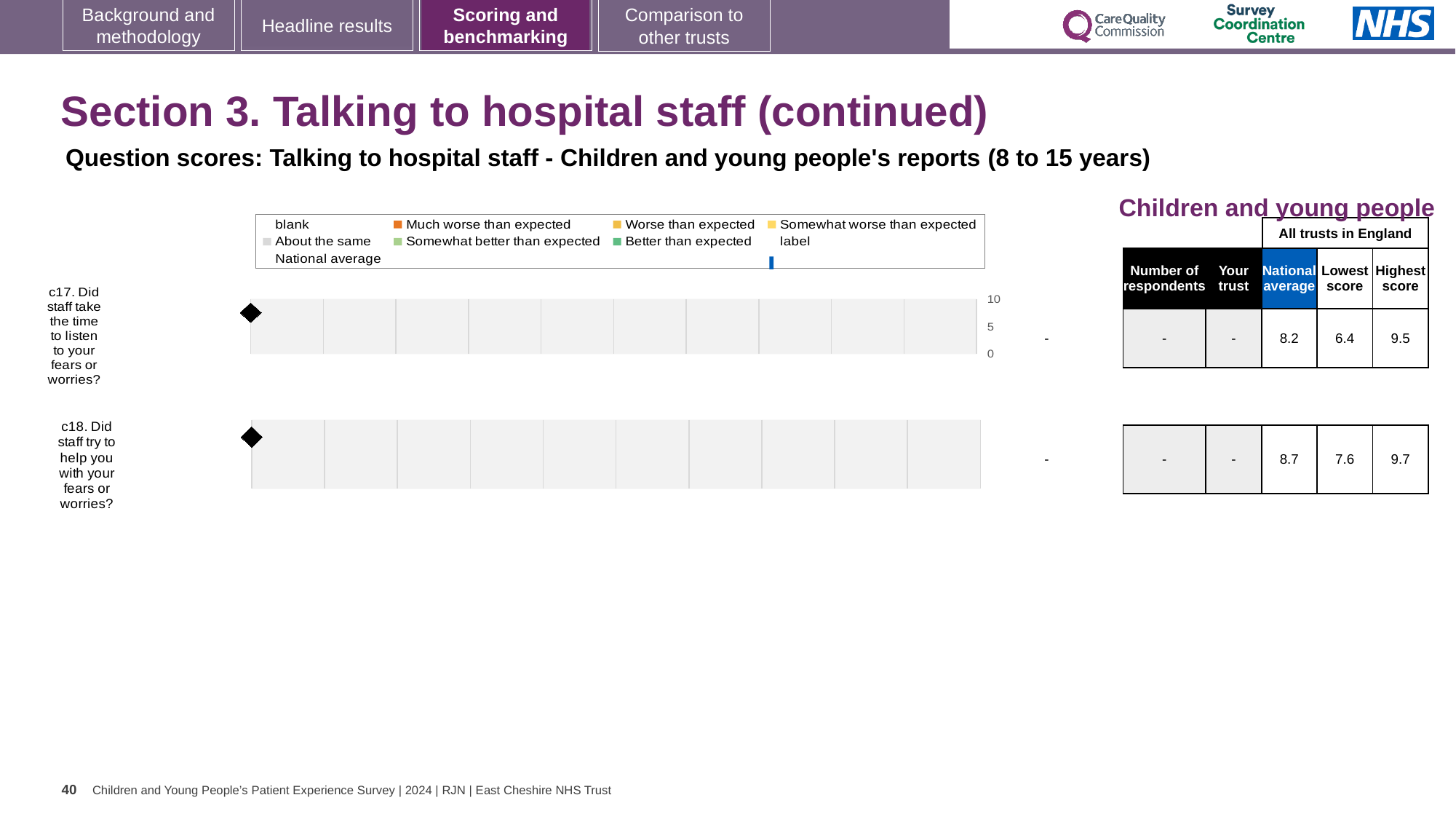
Which question has the higher national average, c17 or c18? c18 In the table, what is the national average score for c17 (Did staff take the time to listen to your fears or worries?)? 8.2 What is the lowest score across all trusts in England for c17? 6.4 What is shown in the 'Your trust' column for c17? - What is the maximum value shown on the score axis of the c17 chart? 10 What is the highest score across all trusts in England for c18? 9.7 In the table, what is the national average score for c18 (Did staff try to help you with your fears or worries?)? 8.7 How many questions (c17 and c18) are plotted on the slide? 2 What is the difference between the highest score and the lowest score for c18? 2.1 What is the difference between the highest score and the lowest score for c17? 3.1 What kind of chart is used for the question scores on this slide? bar chart